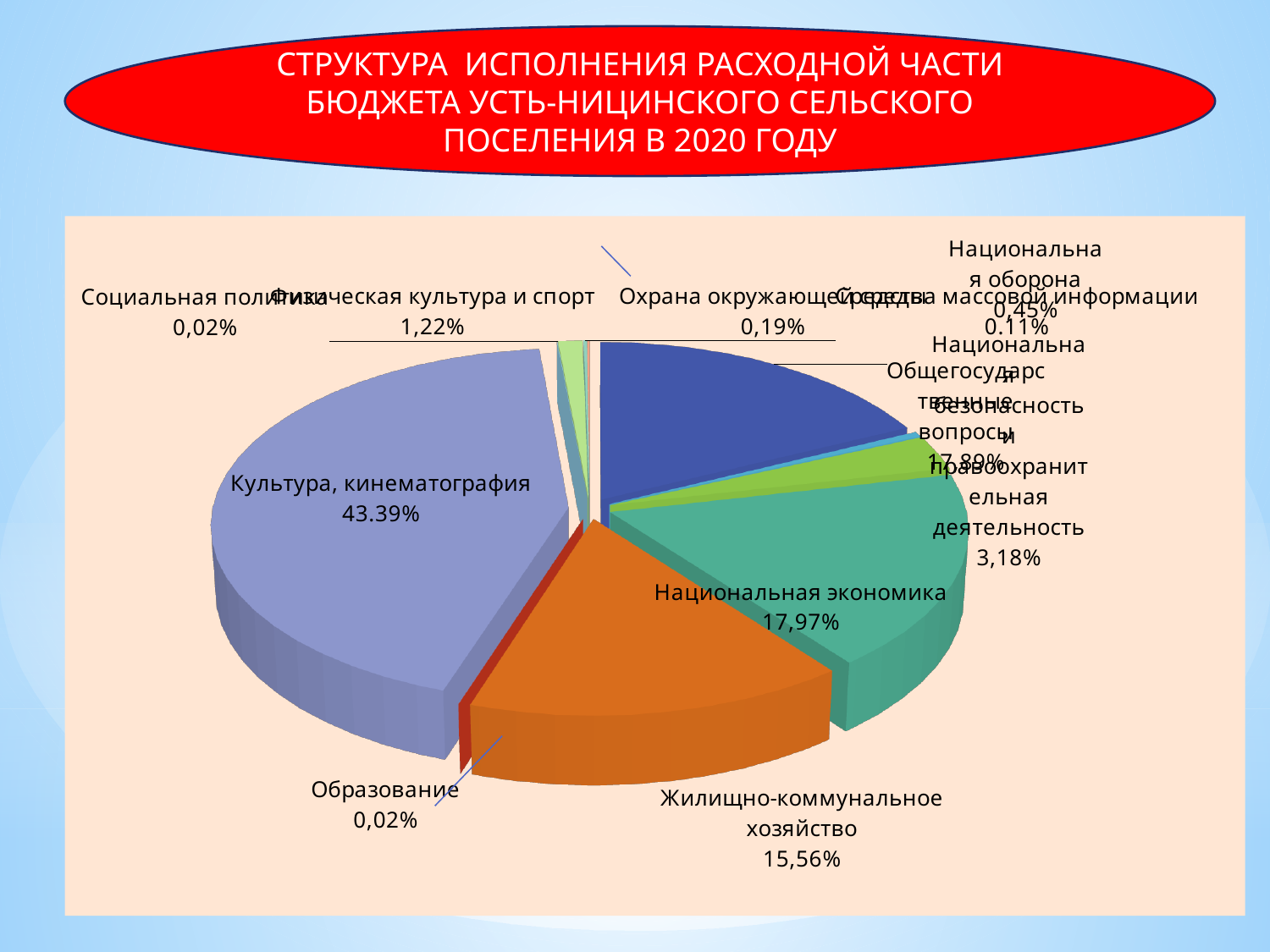
What is the value shown for Национальная экономика? 17,97% What is the difference between the shares of Национальная экономика and Жилищно-коммунальное хозяйство? 2,41% What kind of chart is shown on the slide? pie chart What is the value shown for Жилищно-коммунальное хозяйство? 15,56% Which is larger: Национальная экономика or Жилищно-коммунальное хозяйство? Национальная экономика What is the value shown for Образование? 0,02% What is the value shown for Национальная безопасность и правоохранительная деятельность? 3,18% What is the value shown for Физическая культура и спорт? 1,22% What share of the budget expenditure goes to Культура, кинематография? 43.39% Which category has the largest share of the pie? Культура, кинематография Which year does the chart title say the budget expenditure structure refers to? 2020 What is the value shown for Охрана окружающей среды? 0,19%